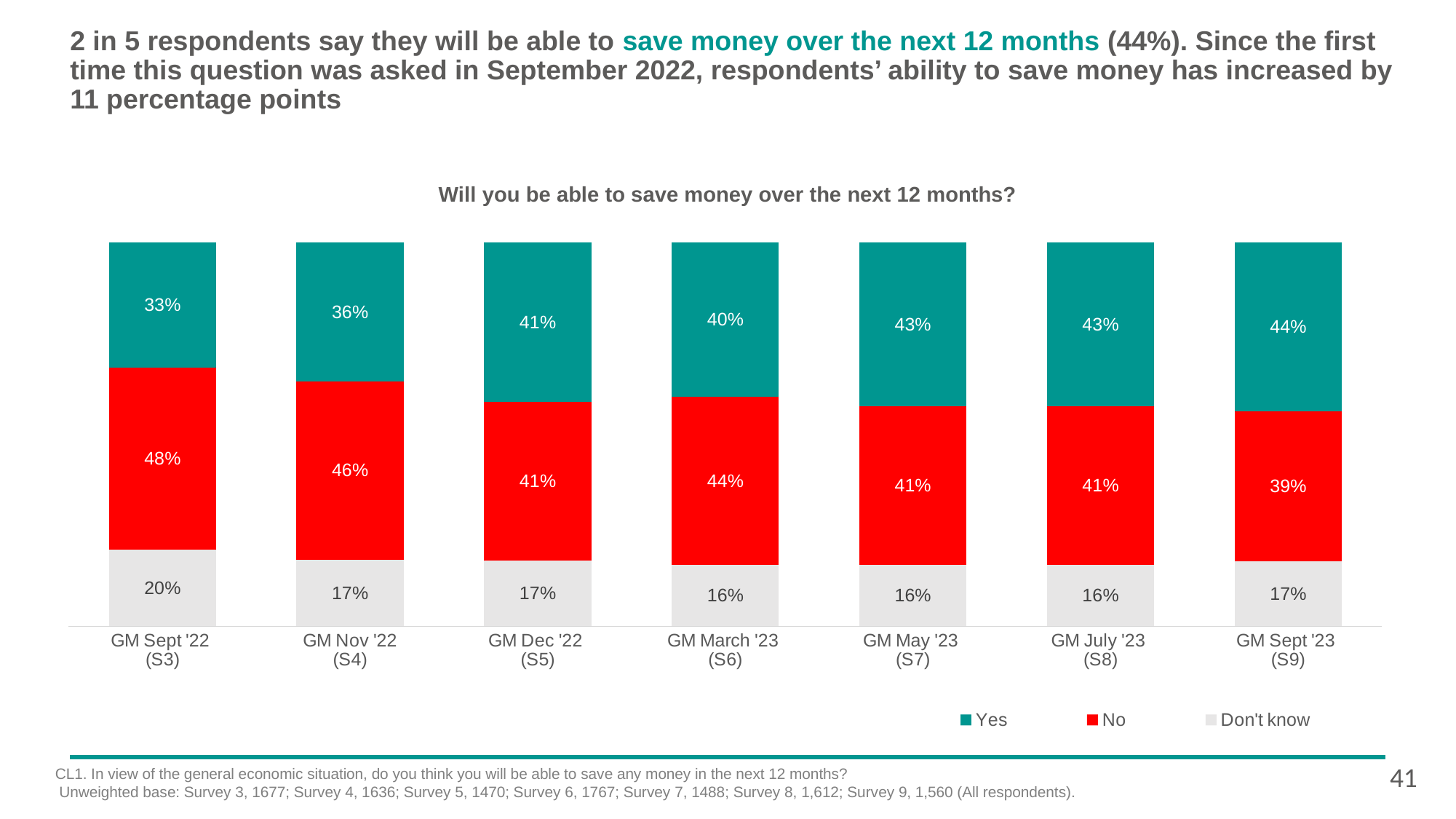
In which survey wave is the 'Yes' share highest? GM Sept '23 (S9) In which survey wave is the 'No' share lowest? GM Sept '23 (S9) What is the difference in the 'Yes' share between GM Sept '23 (S9) and GM Sept '22 (S3)? 11 percentage points How many series does the legend list? 3 What colour represents the 'No' series in the chart? Red Does the 'Don't know' share rise or fall from GM Sept '22 (S3) to GM March '23 (S6)? Fall What percentage of respondents answered 'Yes' in GM Sept '22 (S3)? 33% Which is larger in GM Nov '22 (S4): the 'Yes' share or the 'No' share? No How many survey waves are shown on the x axis? 7 What percentage of respondents answered 'Don't know' in GM Sept '23 (S9)? 17% What kind of chart is shown on the slide? Stacked bar chart What percentage of respondents answered 'No' in GM March '23 (S6)? 44%